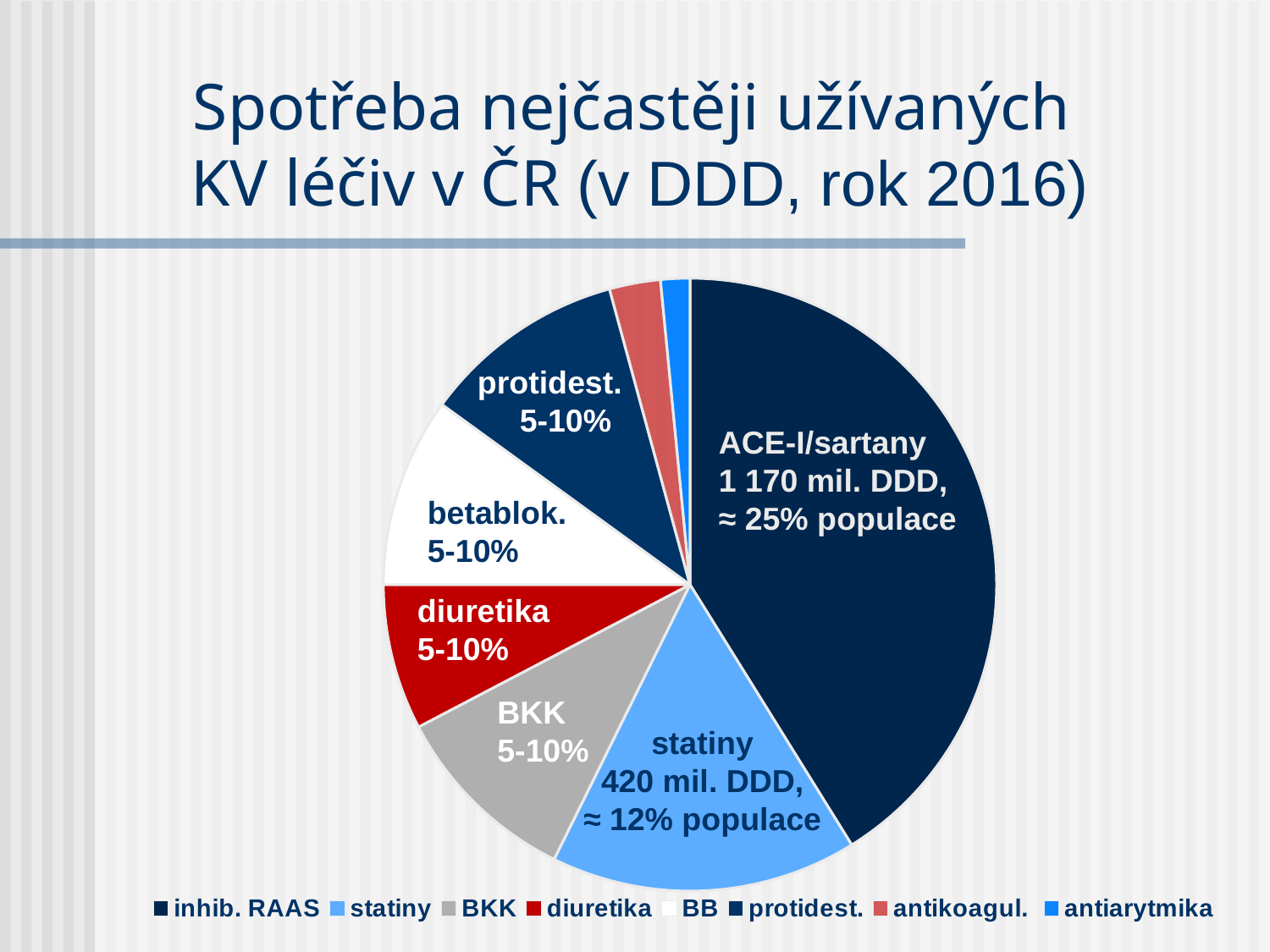
What share of the population is given for statiny? ≈ 12% populace What is the difference in mil. DDD between ACE-I/sartany and statiny? 750 mil. DDD What is the title of the chart slide? Spotřeba nejčastěji užívaných KV léčiv v ČR (v DDD, rok 2016) What share of the population is given for ACE-I/sartany? ≈ 25% populace What kind of chart is shown on the slide? pie chart What consumption in mil. DDD is shown for ACE-I/sartany? 1 170 mil. DDD Which slice is larger, statiny or BKK? statiny Which slice of the pie is the largest? ACE-I/sartany (inhib. RAAS) What consumption in mil. DDD is shown for statiny? 420 mil. DDD Which slice of the pie is the smallest? antiarytmika How many entries does the legend list? 8 What percentage range is shown for diuretika? 5-10%